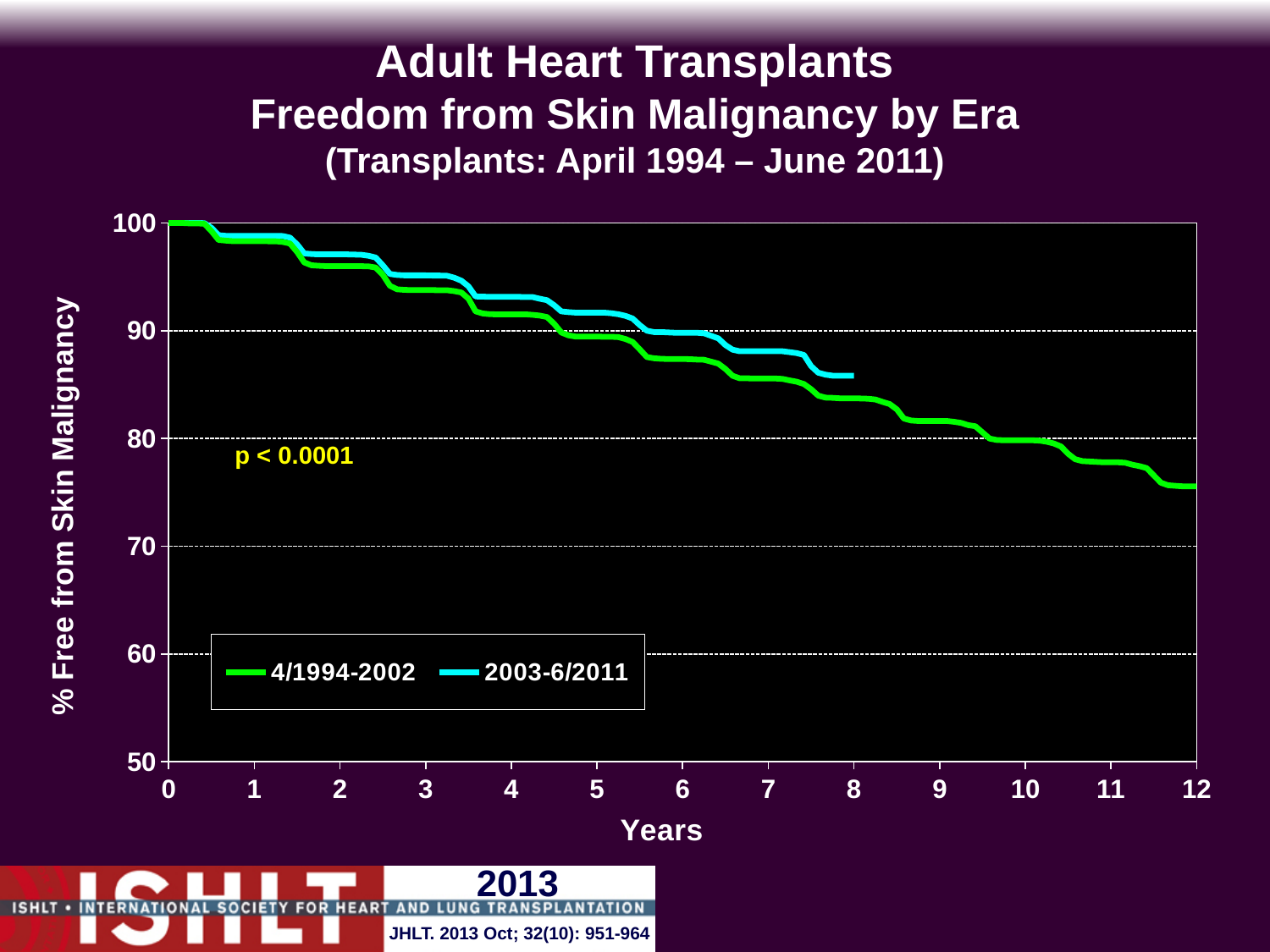
Do the values for the 4/1994-2002 series rise or fall as years increase? fall What kind of chart is shown on the slide? line chart Do the values for the 2003-6/2011 series rise or fall as years increase? fall Which series extends to 12 years on the x axis? 4/1994-2002 Is the value for the 4/1994-2002 series at 12 years greater or less than 80? less What p-value is printed on the chart? p < 0.0001 What is the label of the y axis? % Free from Skin Malignancy At 6 years, which series has the higher value, 4/1994-2002 or 2003-6/2011? 2003-6/2011 Is the value for the 2003-6/2011 series at 4 years greater or less than 90? greater How many series does the legend list? 2 Is the value for the 4/1994-2002 series at 6 years greater or less than 90? less